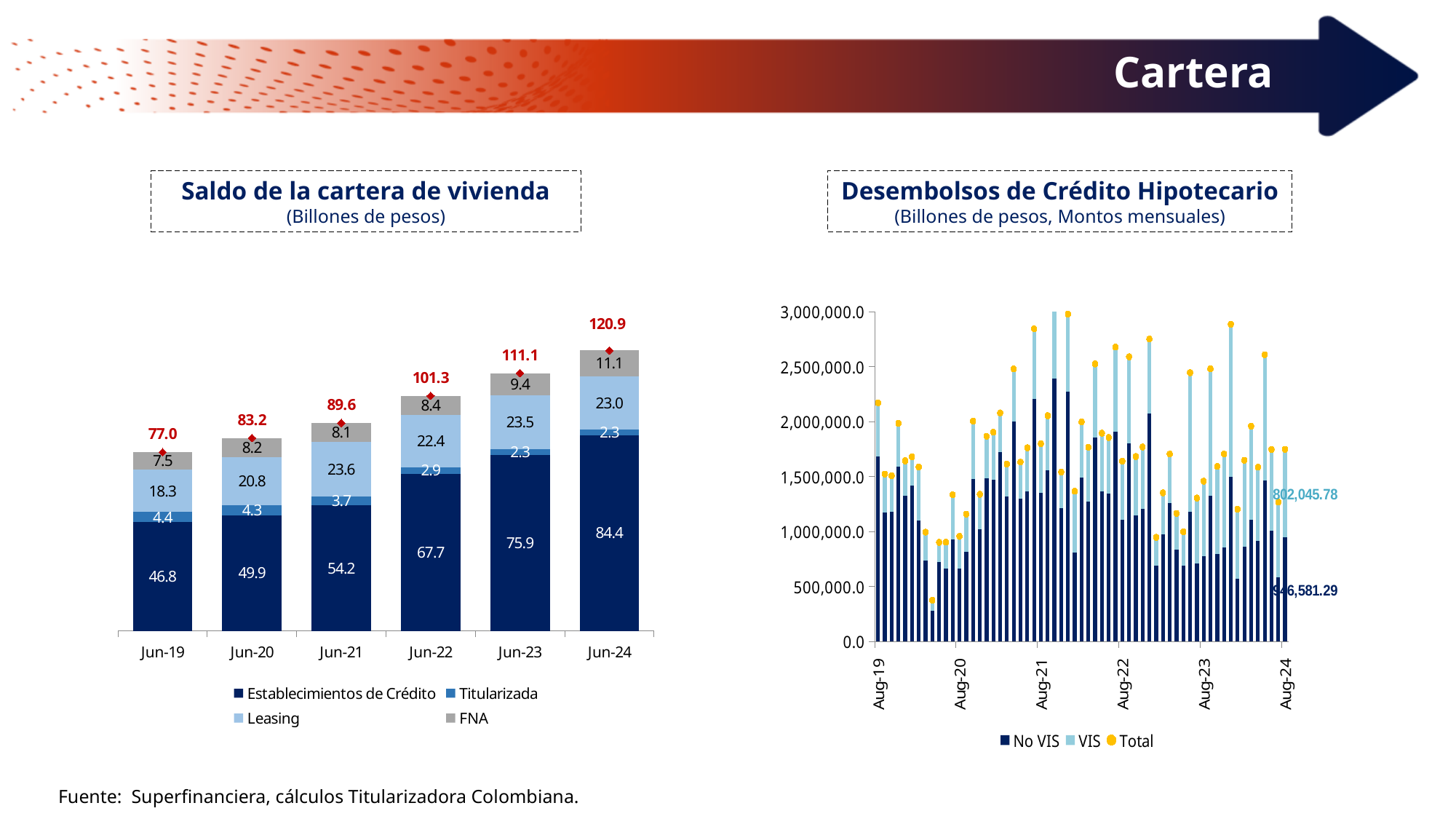
How many series does the legend of the 'Saldo de la cartera de vivienda' chart list? 4 In the 'Saldo de la cartera de vivienda' chart, what is the FNA value for Jun-19? 7.5 What kind of chart is the 'Saldo de la cartera de vivienda' chart? Stacked bar chart In the 'Saldo de la cartera de vivienda' chart, how many time periods are shown on the x axis? 6 In the 'Saldo de la cartera de vivienda' chart, do the bar totals rise or fall from Jun-19 to Jun-24? Rise How many entries does the legend of the 'Desembolsos de Crédito Hipotecario' chart list? 3 In the 'Desembolsos de Crédito Hipotecario' chart, what is the labelled No VIS value for Aug-24? 946,581.29 In the 'Saldo de la cartera de vivienda' chart, what is the difference between the Establecimientos de Crédito values for Jun-24 and Jun-19? 37.6 In the 'Saldo de la cartera de vivienda' chart, what is the total labelled above the Jun-22 bar? 101.3 In the 'Saldo de la cartera de vivienda' chart, is the Leasing value larger in Jun-21 or Jun-22? Jun-21 In the 'Saldo de la cartera de vivienda' chart, which period has the highest total? Jun-24 In the 'Saldo de la cartera de vivienda' chart, what is the value for Establecimientos de Crédito in Jun-24? 84.4